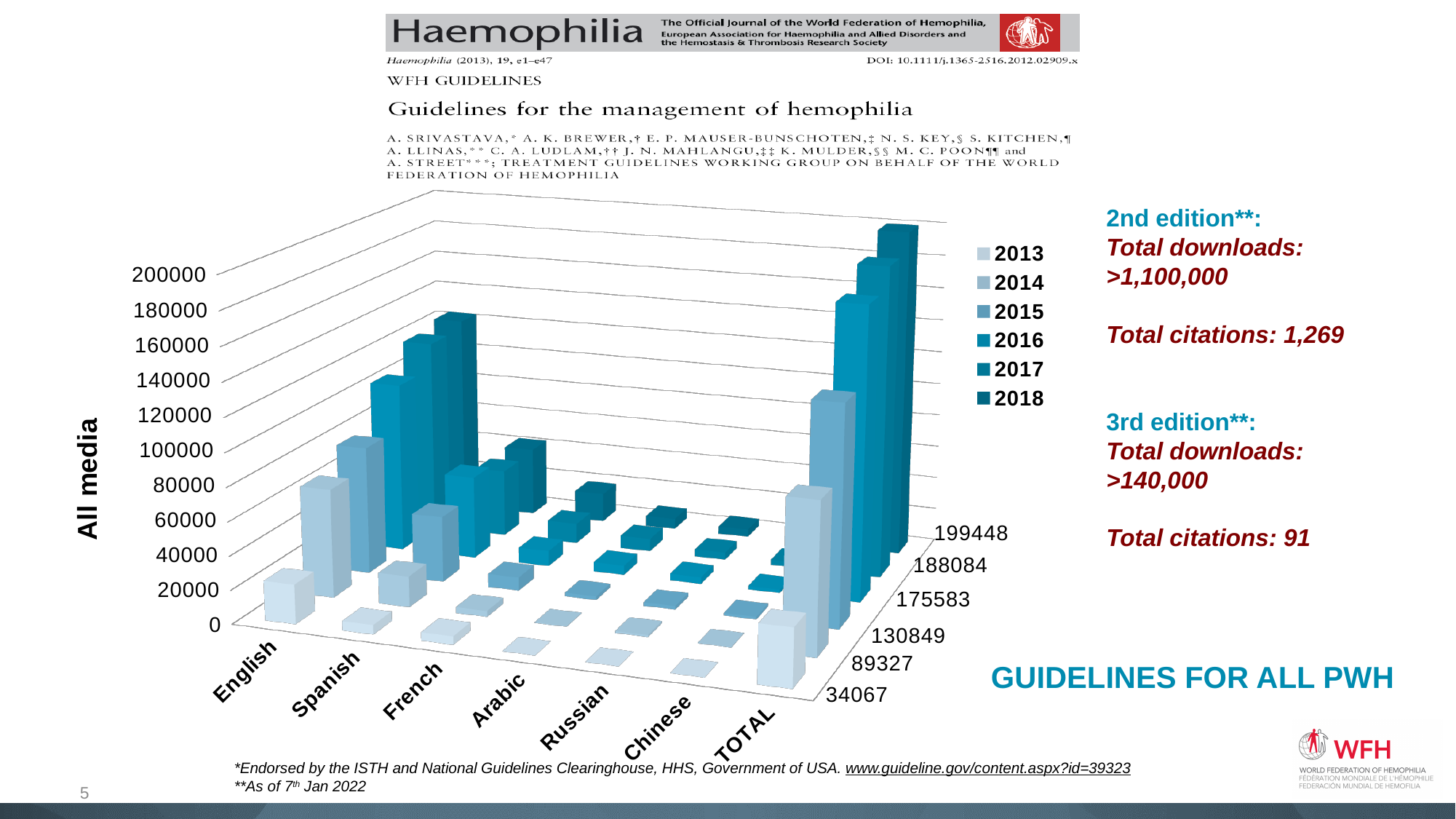
How many categories are shown on the x axis? 7 What is the value for TOTAL in 2013? 34067 What is the value for TOTAL in 2016? 175583 Do the TOTAL values rise or fall from 2013 to 2018? rise What is the value for TOTAL in 2015? 130849 Which language category has the highest bar? English What is the value for TOTAL in 2018? 199448 What kind of chart is shown? bar chart Which is larger, the TOTAL value for 2017 or for 2016? 2017 What is the difference between the TOTAL values for 2017 and 2016? 12501 How many series does the legend list? 6 What is the difference between the TOTAL values for 2018 and 2013? 165381